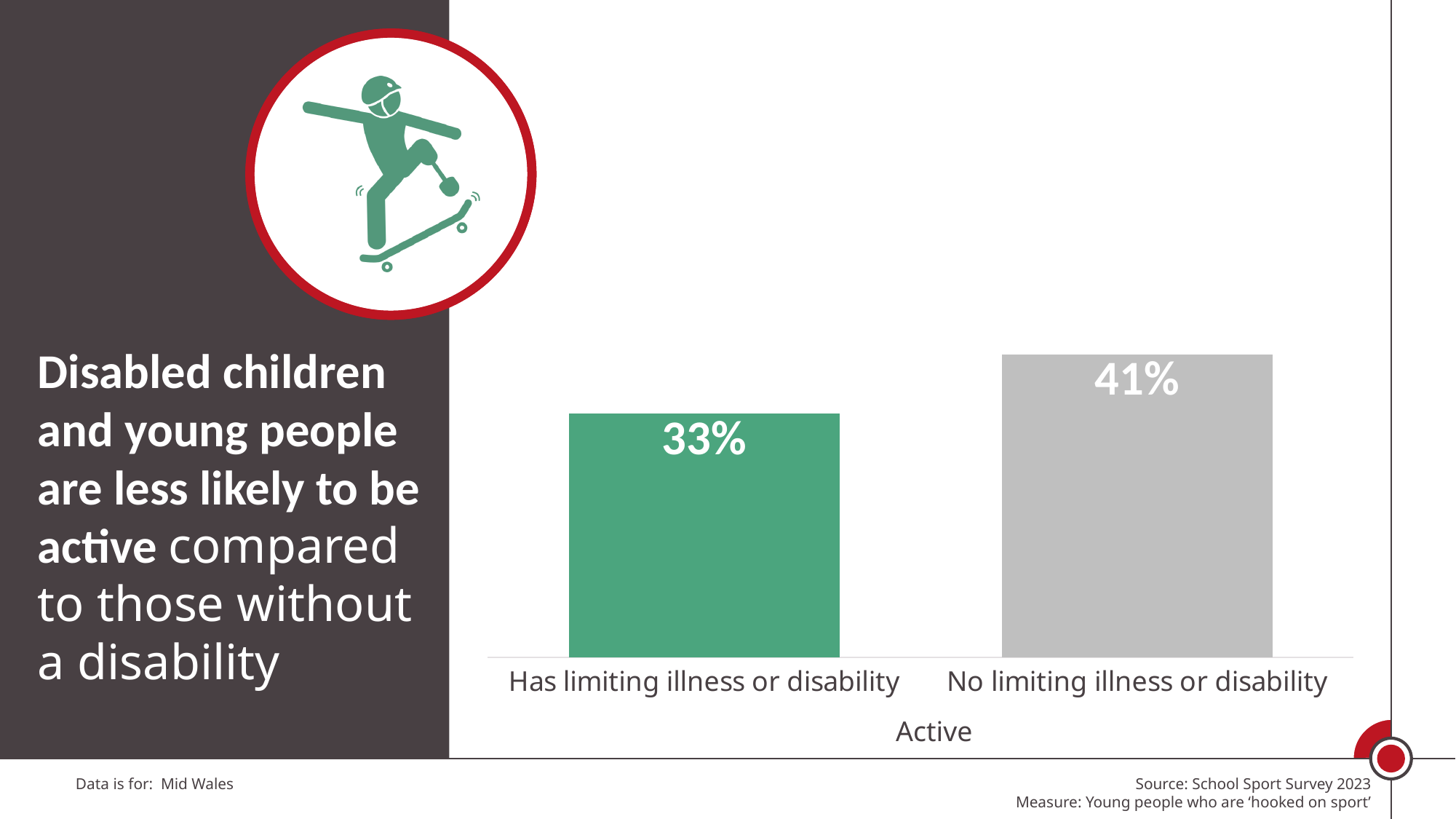
What kind of chart is shown on the slide? Bar chart How many categories are shown in the chart? 2 Which is larger: the value for 'Has limiting illness or disability' or 'No limiting illness or disability'? No limiting illness or disability What is the label shown beneath the category axis of the chart? Active What is the difference between the values for 'No limiting illness or disability' and 'Has limiting illness or disability'? 8% Which category has the lowest value? Has limiting illness or disability What is the value for 'Has limiting illness or disability'? 33% What is the value for 'No limiting illness or disability'? 41% Which category has the highest value? No limiting illness or disability What colour is the bar for 'Has limiting illness or disability'? Green